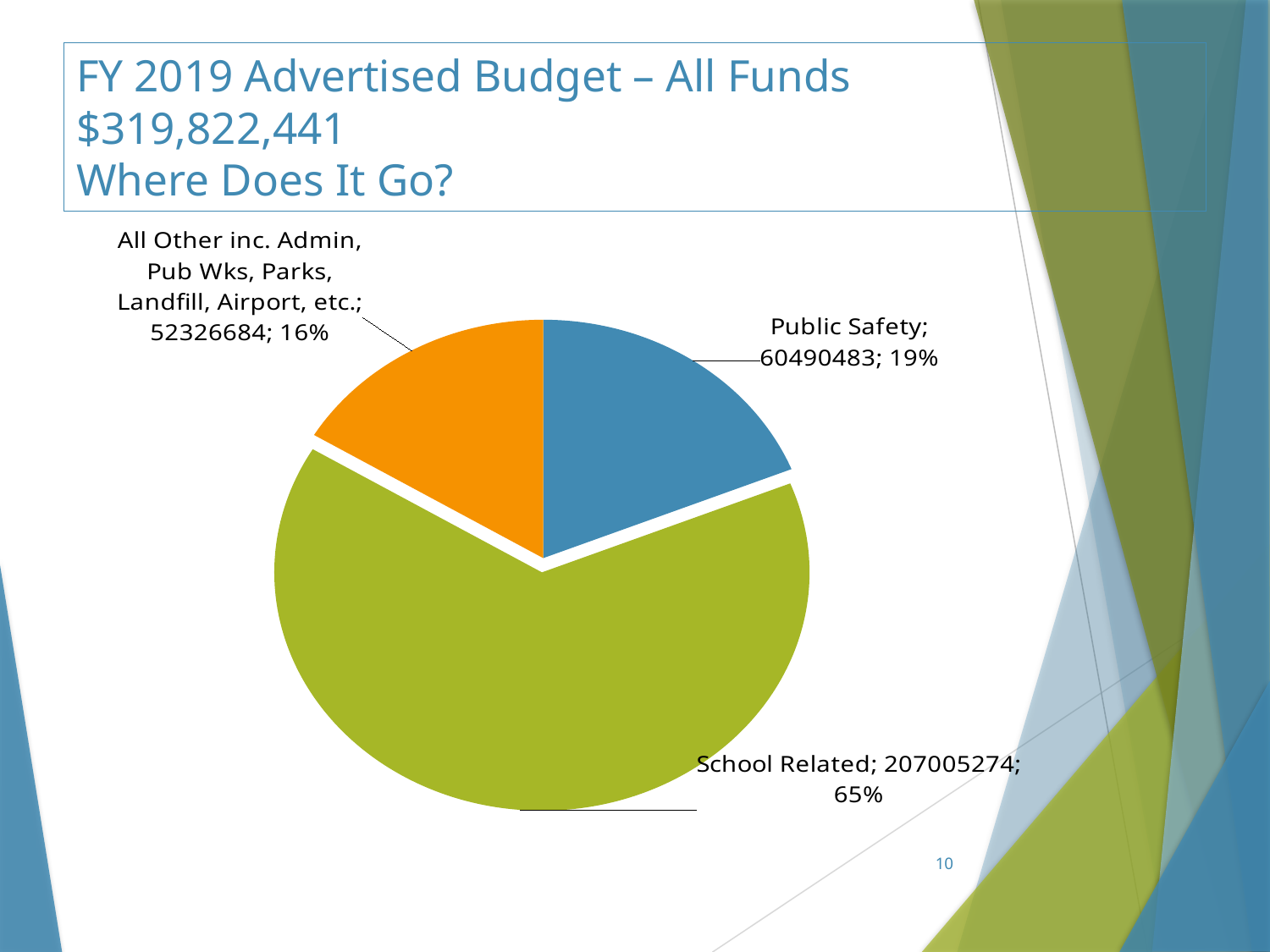
Which is larger, the value for Public Safety or the value for All Other inc. Admin, Pub Wks, Parks, Landfill, Airport, etc.? Public Safety What is the difference between the School Related value and the Public Safety value? 146514791 What is the value shown for the All Other inc. Admin, Pub Wks, Parks, Landfill, Airport, etc. slice? 52326684 What percentage share of the pie does School Related represent? 65% What is the value shown for Public Safety? 60490483 What percentage share of the pie does Public Safety represent? 19% How many slices does the pie chart have? 3 What colour is the School Related slice? Green What is the value shown for School Related? 207005274 Which category has the largest slice of the pie? School Related Which category has the smallest slice of the pie? All Other inc. Admin, Pub Wks, Parks, Landfill, Airport, etc. What type of chart is shown on the slide? Pie chart